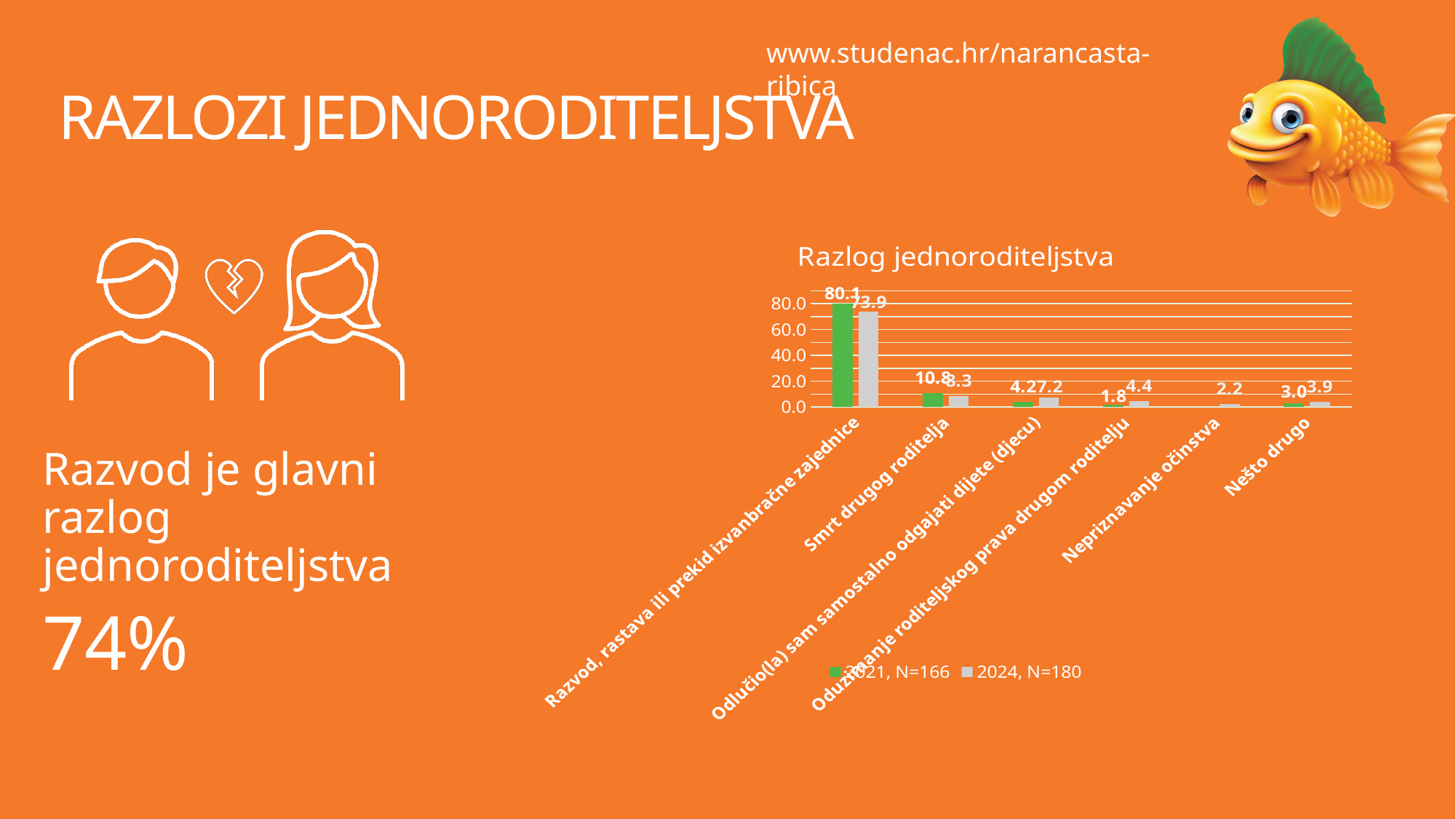
What is the 2024, N=180 value for 'Oduzimanje roditeljskog prava drugom roditelju'? 4.4 Which category has the highest value for the 2024, N=180 series? Razvod, rastava ili prekid izvanbračne zajednice How many series does the chart legend list? 2 For 'Odlučio(la) sam samostalno odgajati dijete (djecu)', which series has the larger value, 2021, N=166 or 2024, N=180? 2024, N=180 What is the 2024, N=180 value for 'Smrt drugog roditelja'? 8.3 Is the 2021, N=166 value for 'Smrt drugog roditelja' greater or less than 20.0? less How many categories are shown on the x axis of the chart? 6 What is the title of the chart? Razlog jednoroditeljstva What is the 2021, N=166 value for 'Razvod, rastava ili prekid izvanbračne zajednice'? 80.1 What is the difference between the 2021, N=166 and 2024, N=180 values for 'Razvod, rastava ili prekid izvanbračne zajednice'? 6.2 What type of chart is shown on the slide? bar chart What is the 2021, N=166 value for 'Nešto drugo'? 3.0